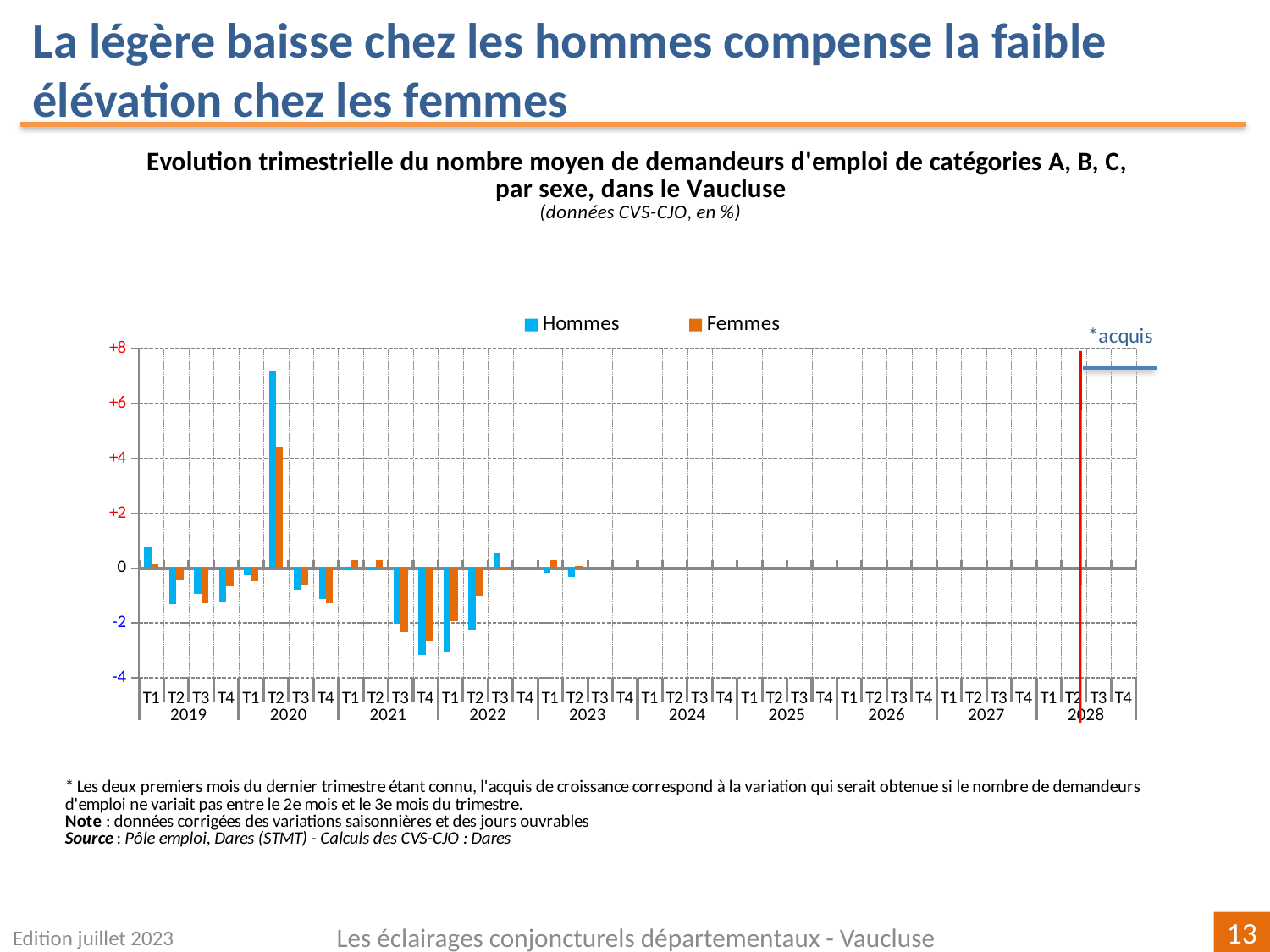
What are the two series named in the legend? Hommes and Femmes Is the Hommes value for T4 2021 greater or less than -2? less What kind of chart is shown on the slide? bar chart In which quarter does the Femmes series reach its highest value? T2 2020 How many years are labelled along the x axis? 10 Is the Hommes value for T1 2019 greater or less than +2? less In which quarter does the Hommes series reach its highest value? T2 2020 In T2 2020, which series has the larger value, Hommes or Femmes? Hommes Is the Femmes value for T2 2020 greater or less than +2? greater Which colour represents the Hommes series? blue How many series does the legend list? 2